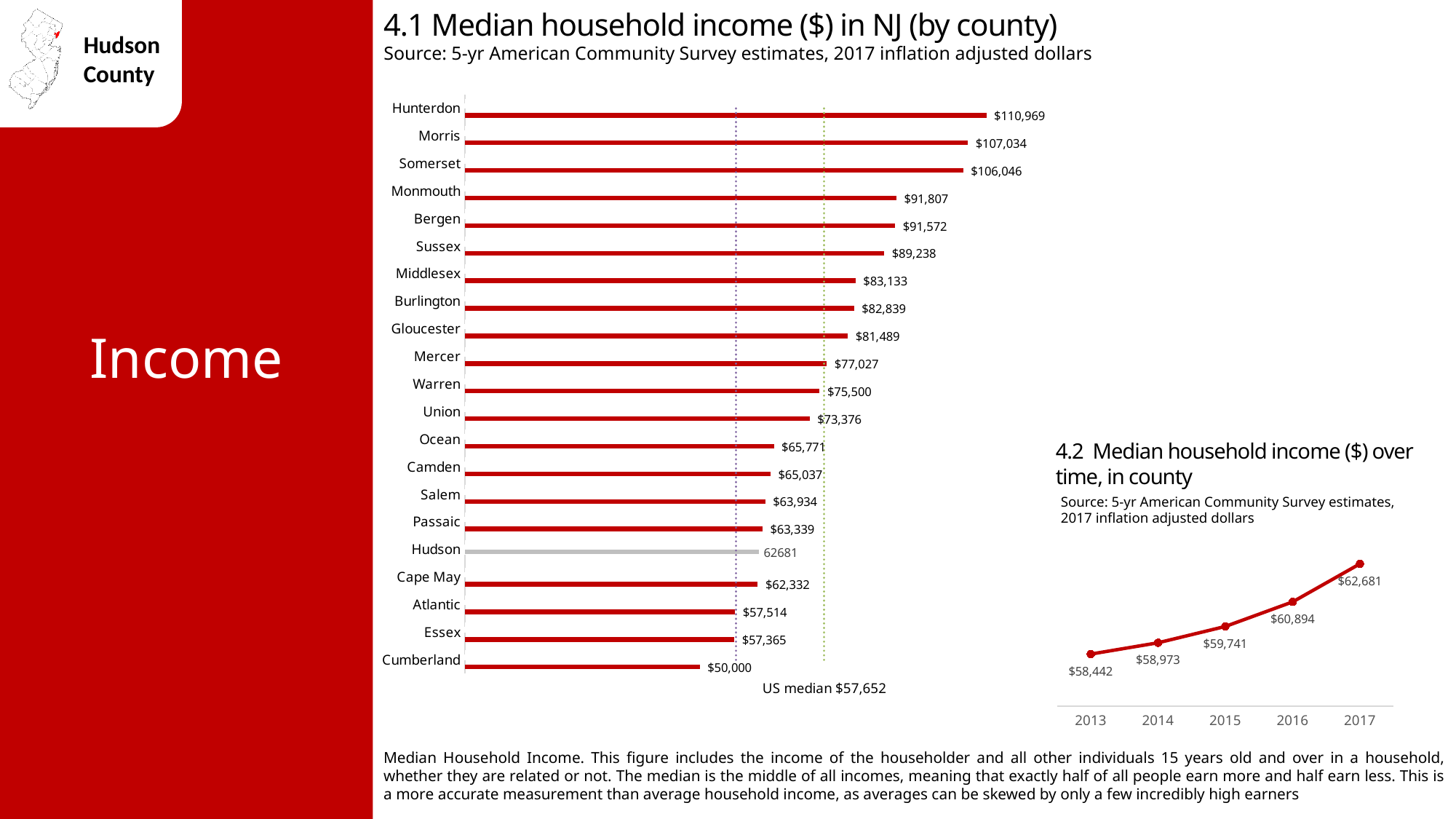
What kind of chart is chart 4.1? Bar chart In chart 4.1 (Median household income in NJ by county), what is the median household income for Bergen? $91,572 In chart 4.1, which county has the highest median household income? Hunterdon In chart 4.2 (Median household income over time, in county), what is the value for 2015? $59,741 In chart 4.2, what is the difference between the 2017 and 2013 values? $4,239 In chart 4.1, which county has a higher median household income, Monmouth or Middlesex? Monmouth In chart 4.2, how many years are plotted? 5 In chart 4.1, how many counties are shown? 21 In chart 4.1, what is the difference between the median household income of Hunterdon and Cumberland? $60,969 In chart 4.2, does median household income rise or fall from 2013 to 2017? Rise In chart 4.1, which county has the lowest median household income? Cumberland In chart 4.1, what value is shown for Hudson? 62681